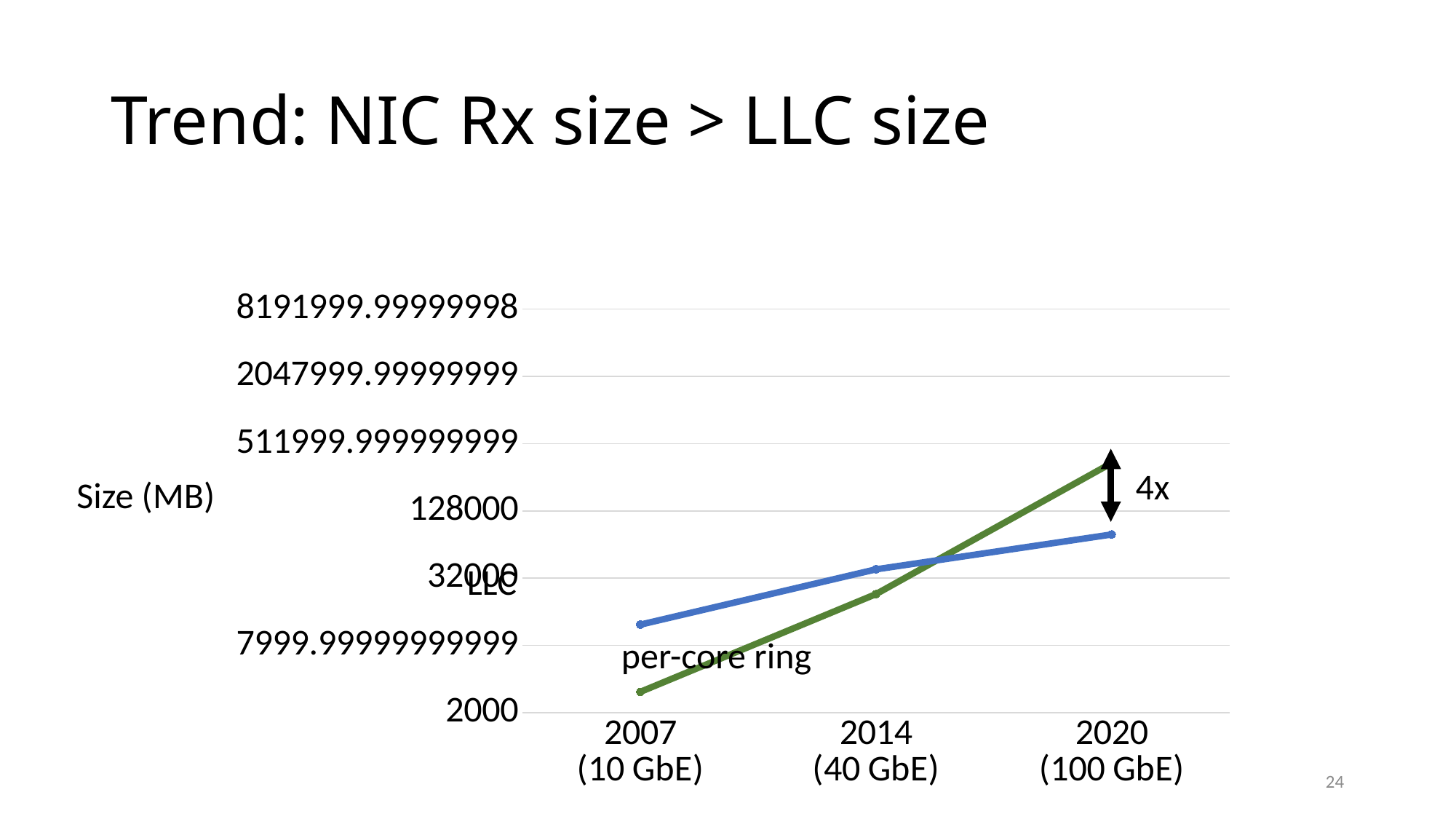
In which year is the per-core ring value highest? 2020 Is the LLC value for 2020 (100 GbE) greater or less than 128000? less How many data series (lines) are plotted on the chart? 2 Does the per-core ring series rise or fall from 2007 to 2020? rise What is the title of the slide containing the chart? Trend: NIC Rx size > LLC size Is the per-core ring value for 2020 (100 GbE) greater or less than 128000? greater Is the per-core ring value for 2007 (10 GbE) greater or less than 7999.9999999999? less Which series is larger in 2007 (10 GbE), LLC or per-core ring? LLC What kind of chart is shown on the slide? line chart What ratio is annotated next to the arrow between the two lines at 2020? 4x How many points along the x axis does the chart have? 3 Which series is larger in 2020 (100 GbE), LLC or per-core ring? per-core ring